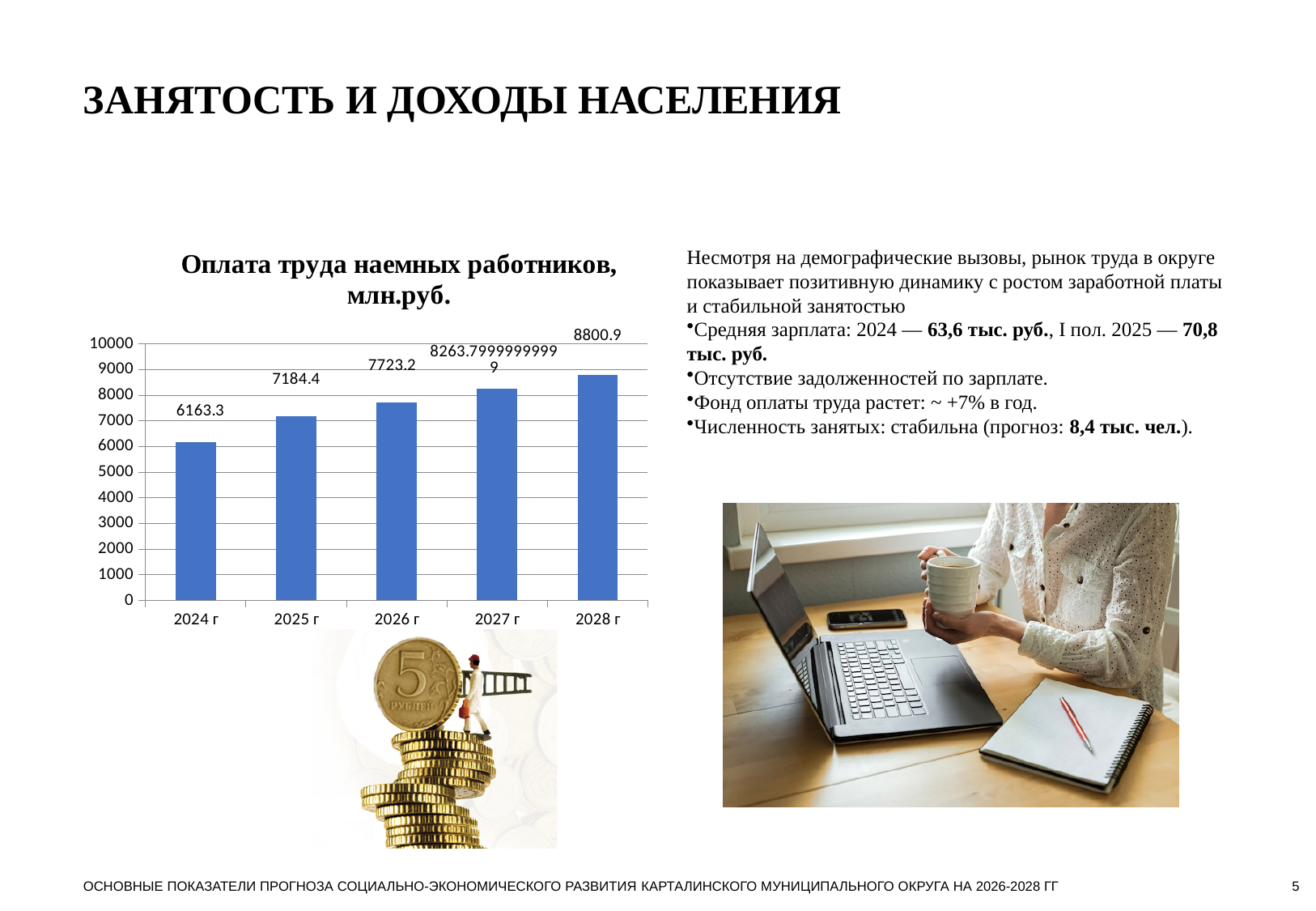
Is the value for 2027 г greater or less than 8000? greater What is the value for 2024 г in the chart? 6163.3 Do the values rise or fall from 2024 г to 2028 г? rise What kind of chart is shown on the slide? bar chart How many years are shown on the x axis of the chart? 5 Which is larger, the value for 2025 г or the value for 2027 г? 2027 г What is the difference between the values for 2025 г and 2024 г? 1021.1 What is the difference between the values for 2028 г and 2026 г? 1077.7 What is the value for 2026 г in the chart? 7723.2 What is the value for 2028 г in the chart? 8800.9 Which year has the highest value in the chart? 2028 г Which year has the lowest value in the chart? 2024 г